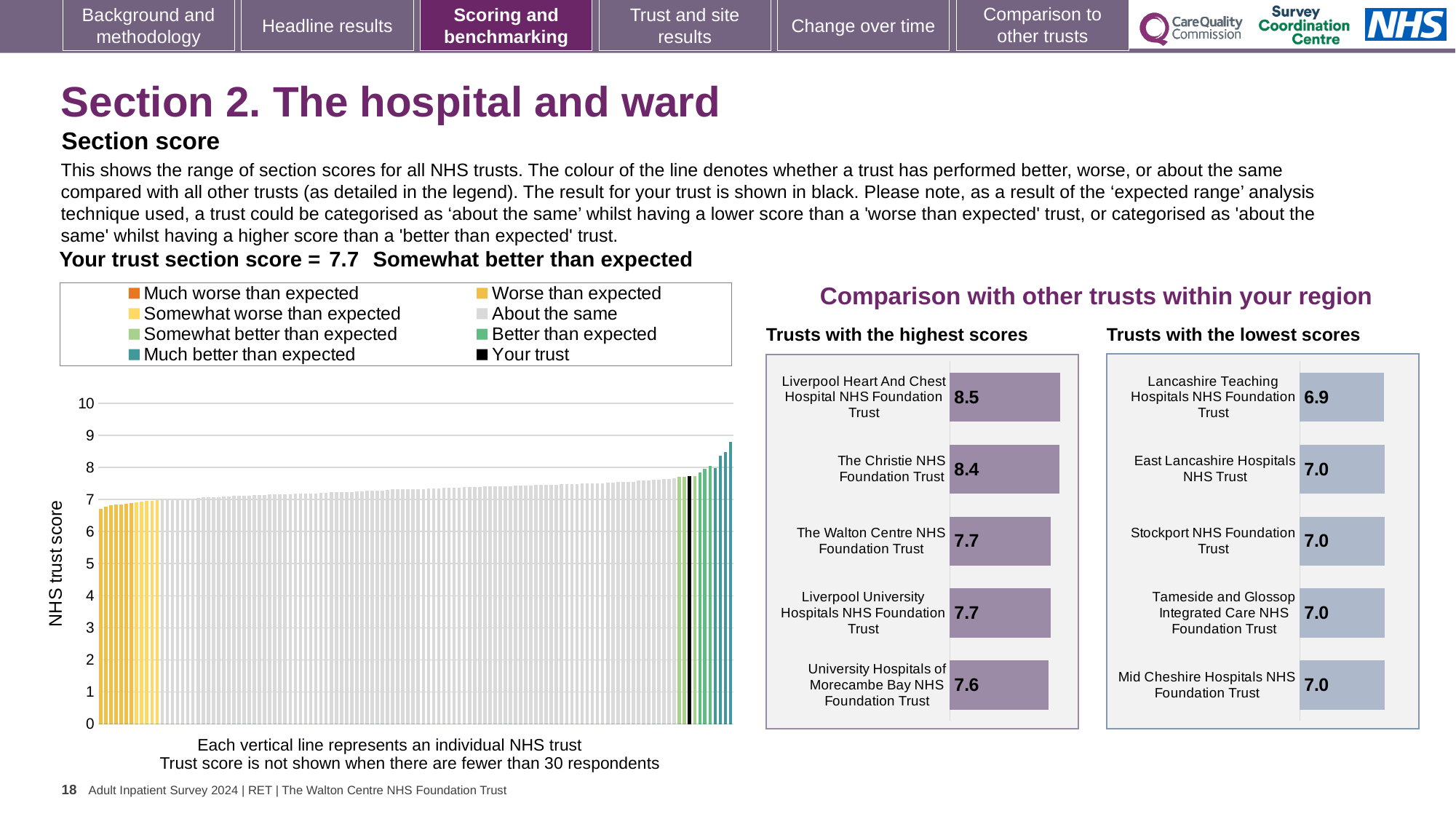
What kind of chart is the main chart showing the range of section scores for all NHS trusts? Bar chart In the 'Trusts with the lowest scores' chart, what is the score for Mid Cheshire Hospitals NHS Foundation Trust? 7.0 In the 'Trusts with the highest scores' chart, what is the difference between the scores of Liverpool Heart And Chest Hospital NHS Foundation Trust and University Hospitals of Morecambe Bay NHS Foundation Trust? 0.9 How many entries does the legend of the main chart list? 8 In the main chart of all NHS trusts, what is the section score for your trust (the black bar)? 7.7 In the 'Trusts with the lowest scores' chart, what is the score for Lancashire Teaching Hospitals NHS Foundation Trust? 6.9 Which is larger: the score for The Christie NHS Foundation Trust in the highest-scores chart or the score for East Lancashire Hospitals NHS Trust in the lowest-scores chart? The Christie NHS Foundation Trust In the 'Trusts with the highest scores' chart, what is the score for The Christie NHS Foundation Trust? 8.4 In the 'Trusts with the highest scores' chart, what is the score for Liverpool Heart And Chest Hospital NHS Foundation Trust? 8.5 In the 'Trusts with the lowest scores' chart, which trust has the lowest score? Lancashire Teaching Hospitals NHS Foundation Trust In the 'Trusts with the highest scores' chart, how many trusts are shown? 5 In the 'Trusts with the highest scores' chart, which trust has the highest score? Liverpool Heart And Chest Hospital NHS Foundation Trust